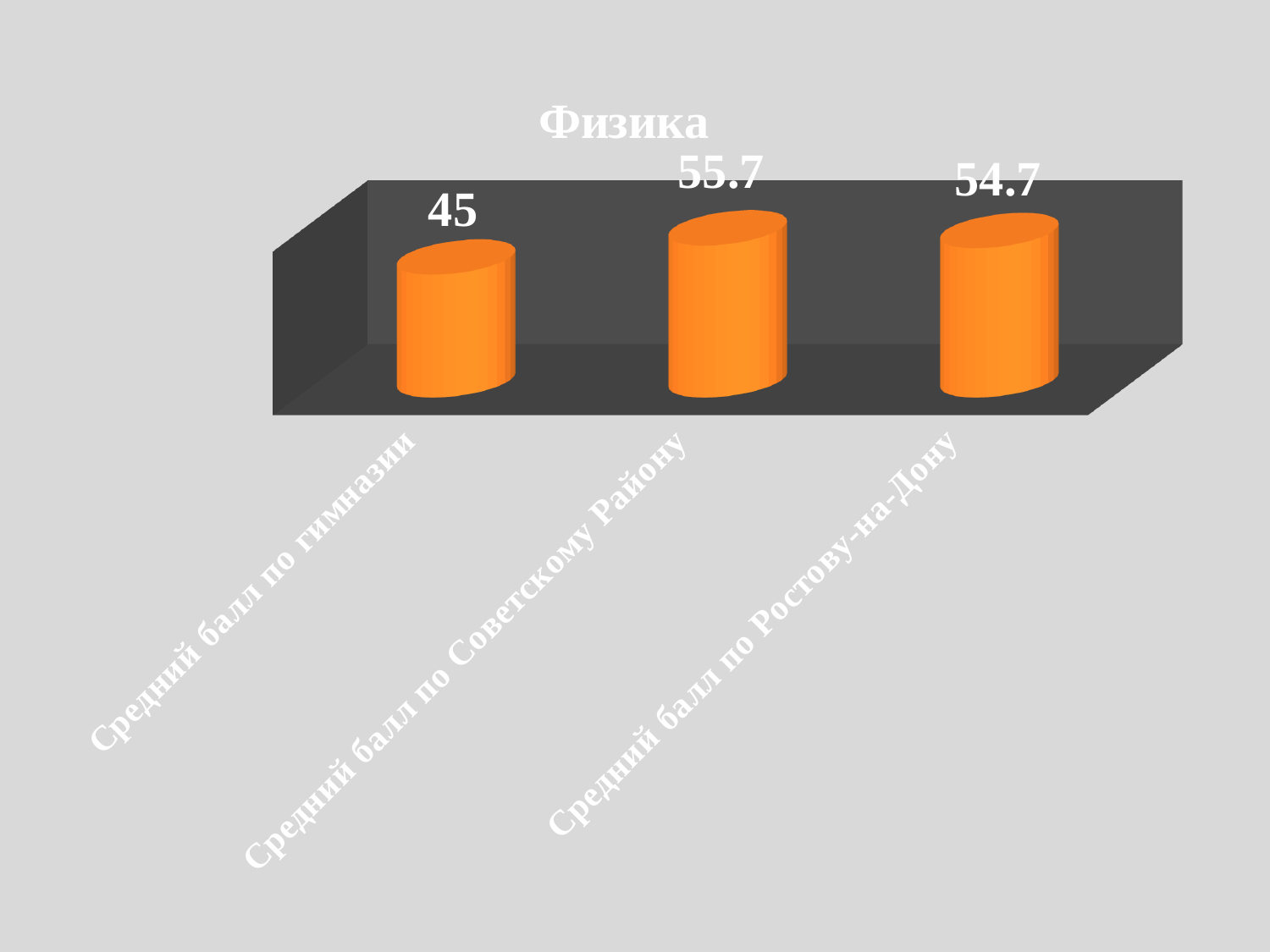
How many categories are plotted in the chart? 3 What is the difference between the value for "Средний балл по Ростову-на-Дону" and the value for "Средний балл по гимназии"? 9.7 Which is larger: the value for "Средний балл по Советскому Району" or the value for "Средний балл по Ростову-на-Дону"? Средний балл по Советскому Району What is the value for "Средний балл по гимназии"? 45 Which category has the lowest value? Средний балл по гимназии What is the difference between the value for "Средний балл по Советскому Району" and the value for "Средний балл по гимназии"? 10.7 What kind of chart is shown on the slide? bar chart Which category has the highest value? Средний балл по Советскому Району What is the value for "Средний балл по Ростову-на-Дону"? 54.7 What colour are the bars in the chart? orange What is the value for "Средний балл по Советскому Району"? 55.7 What is the title of the chart? Физика